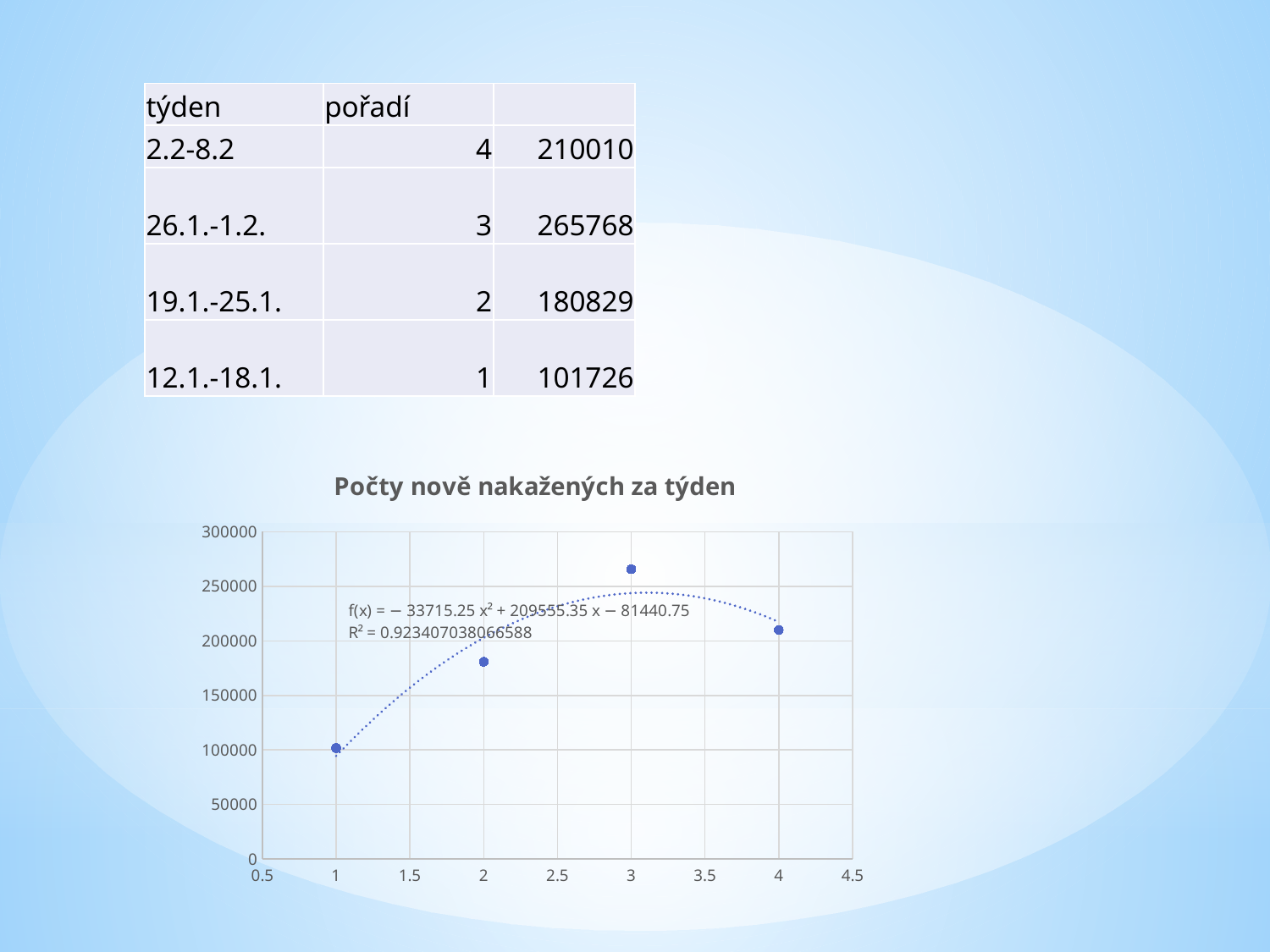
Is the value of the point at x = 1 greater or less than 150000? less Do the plotted values rise or fall from x = 1 to x = 3? rise Is the value of the point at x = 2 greater or less than 200000? less At which x value is the lowest point in the chart? 1 Is the value of the point at x = 3 greater or less than 250000? greater Which point has the larger value, the one at x = 2 or the one at x = 4? x = 4 What is the title of the chart? Počty nově nakažených za týden What kind of chart is shown on the slide? scatter chart What R² value is shown for the trendline in the chart? 0.923407038066588 How many data points are plotted in the chart? 4 At which x value is the highest point in the chart? 3